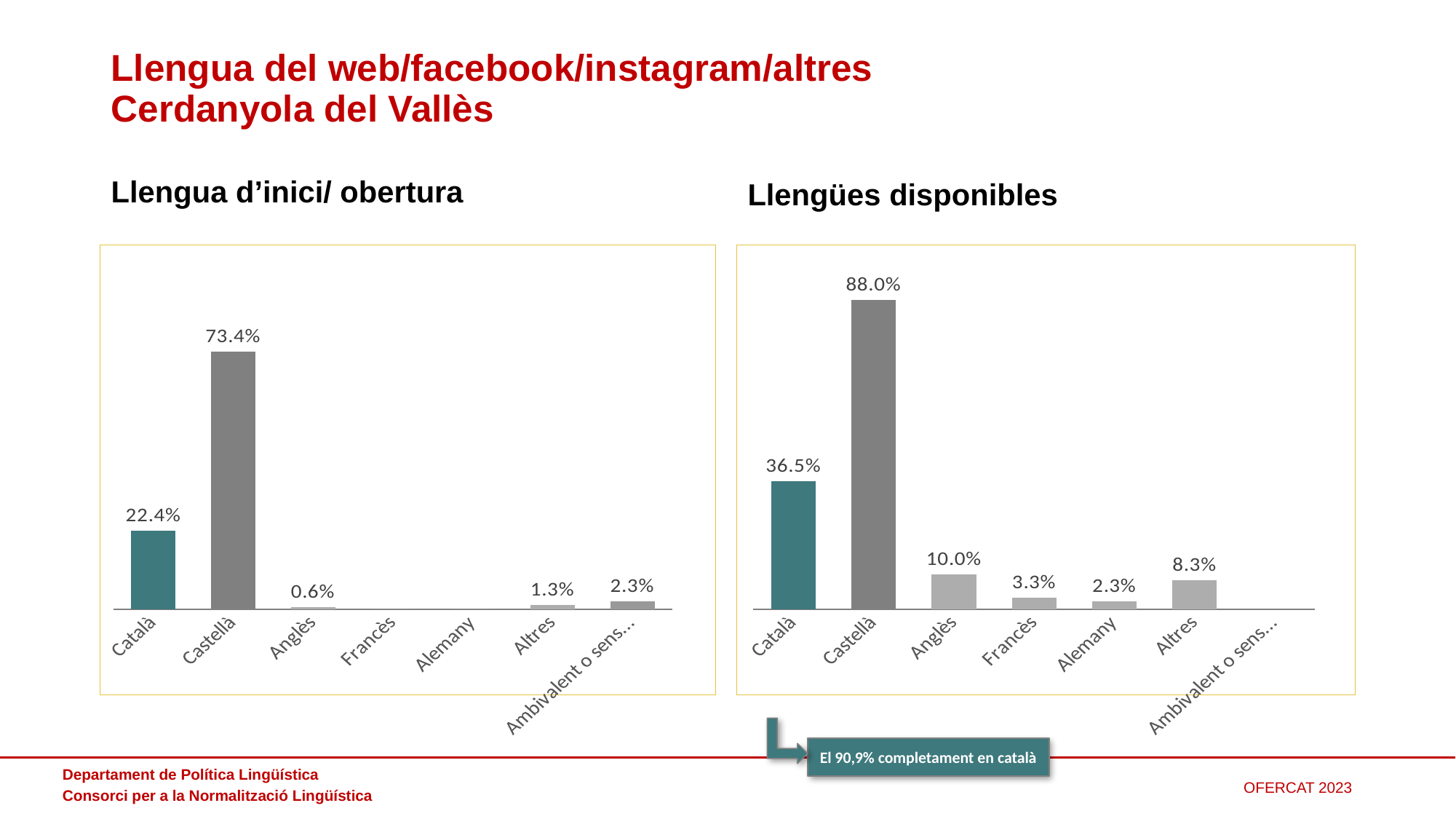
In the 'Llengües disponibles' chart, which is larger, the value for Francès or the value for Alemany? Francès In the 'Llengües disponibles' chart, what is the value for Anglès? 10.0% In the 'Llengües disponibles' chart, what is the value for Altres? 8.3% In the 'Llengua d'inici/ obertura' chart, which category has the highest value? Castellà In the 'Llengua d'inici/ obertura' chart, what is the difference between the values for Castellà and Català? 51.0% How many categories are shown on the x axis of the 'Llengües disponibles' chart? 7 In the 'Llengua d'inici/ obertura' chart, what is the value for Català? 22.4% In the 'Llengua d'inici/ obertura' chart, what is the value for Castellà? 73.4% In the 'Llengua d'inici/ obertura' chart, what is the value for Altres? 1.3% What kind of chart is the 'Llengua d'inici/ obertura' chart? Bar chart In the 'Llengües disponibles' chart, what is the difference between the values for Castellà and Català? 51.5% In the 'Llengües disponibles' chart, which category has the highest value? Castellà